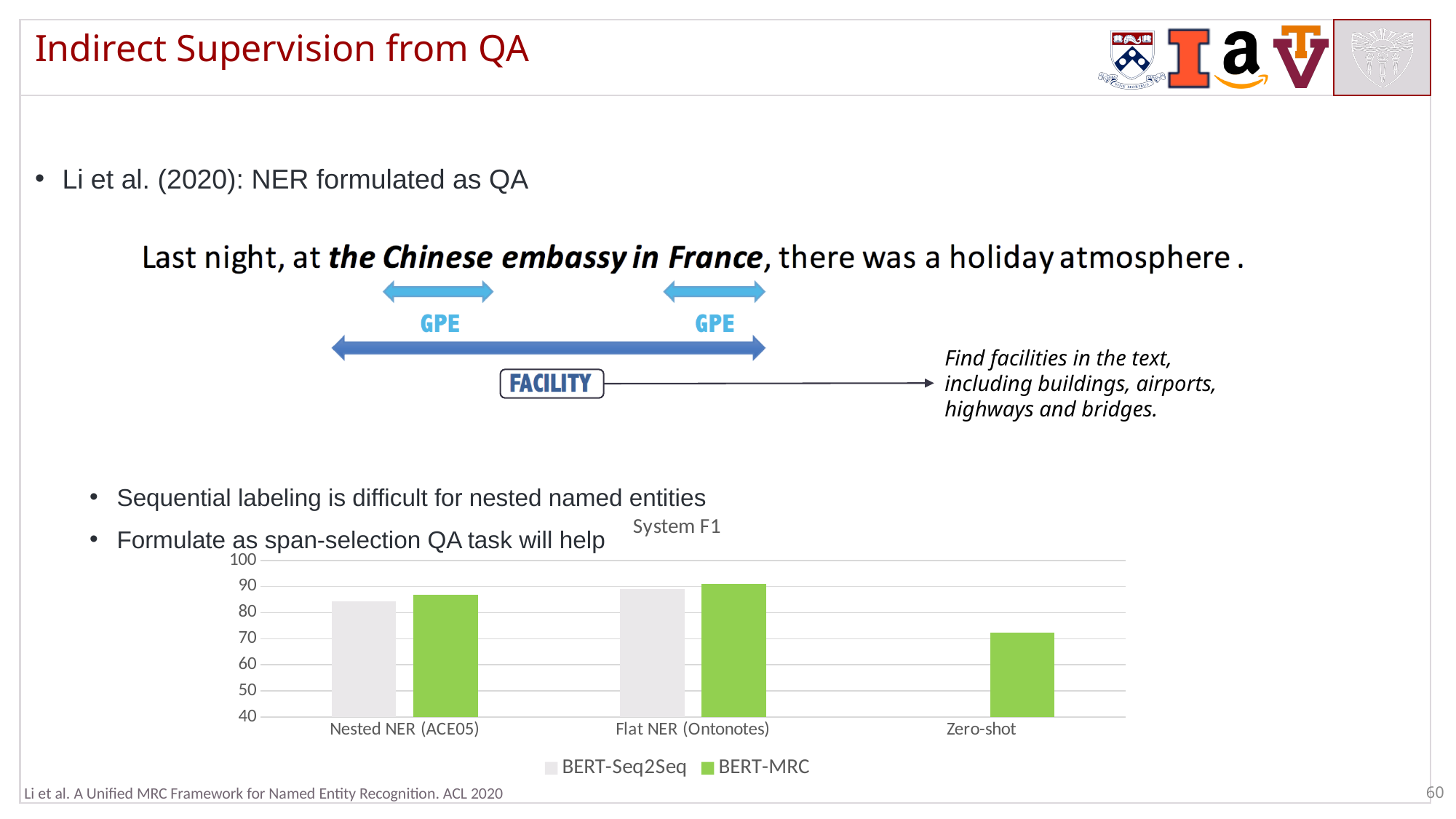
What is the title of the chart? System F1 Is the BERT-Seq2Seq value for Nested NER (ACE05) greater or less than 80? greater How many categories are shown on the x axis of the chart? 3 Which series is shown in green in the chart? BERT-MRC For which category does the BERT-MRC series have its lowest value? Zero-shot For Nested NER (ACE05), which series has the larger value, BERT-Seq2Seq or BERT-MRC? BERT-MRC How many series does the chart's legend list? 2 What kind of chart is shown on the slide? bar chart Which category has no BERT-Seq2Seq bar in the chart? Zero-shot Is the BERT-MRC value for Zero-shot greater or less than 80? less For which category does the BERT-MRC series have its highest value? Flat NER (Ontonotes)